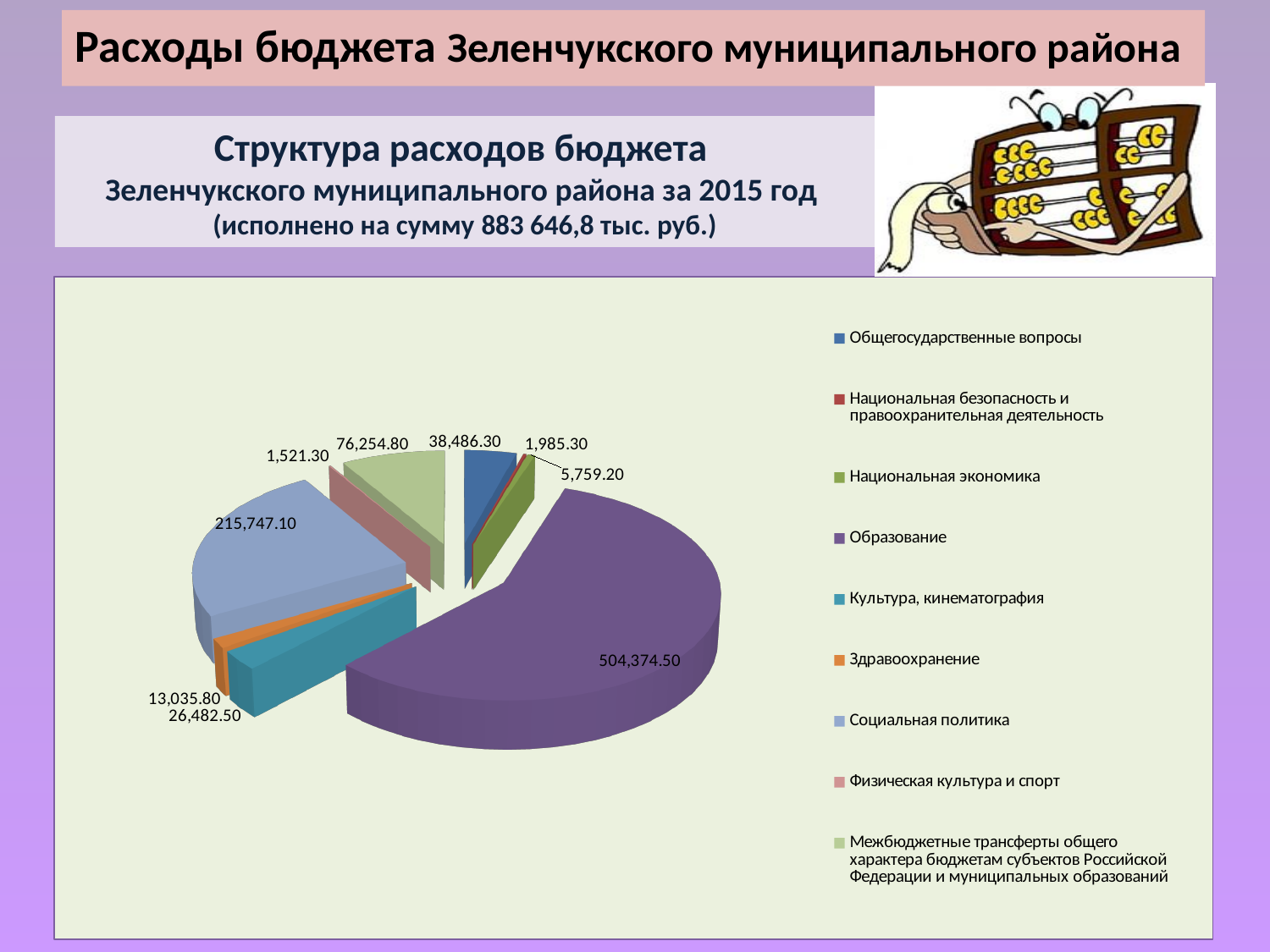
What type of chart is shown on the slide? pie chart What is the difference between the values for Социальная политика and Межбюджетные трансферты общего характера бюджетам субъектов Российской Федерации и муниципальных образований? 139,492.30 What is the value for Общегосударственные вопросы? 38,486.30 What is the value for Социальная политика? 215,747.10 Which is larger, the value for Национальная экономика or the value for Национальная безопасность и правоохранительная деятельность? Национальная экономика What is the value for Культура, кинематография? 26,482.50 How many categories does the legend of the pie chart list? 9 What is the value for Образование? 504,374.50 Which category has the smallest value? Физическая культура и спорт What is the value for Здравоохранение? 13,035.80 What total amount of budget expenditure does the slide state was executed in 2015? 883 646,8 тыс. руб. Which category has the largest slice of the pie? Образование